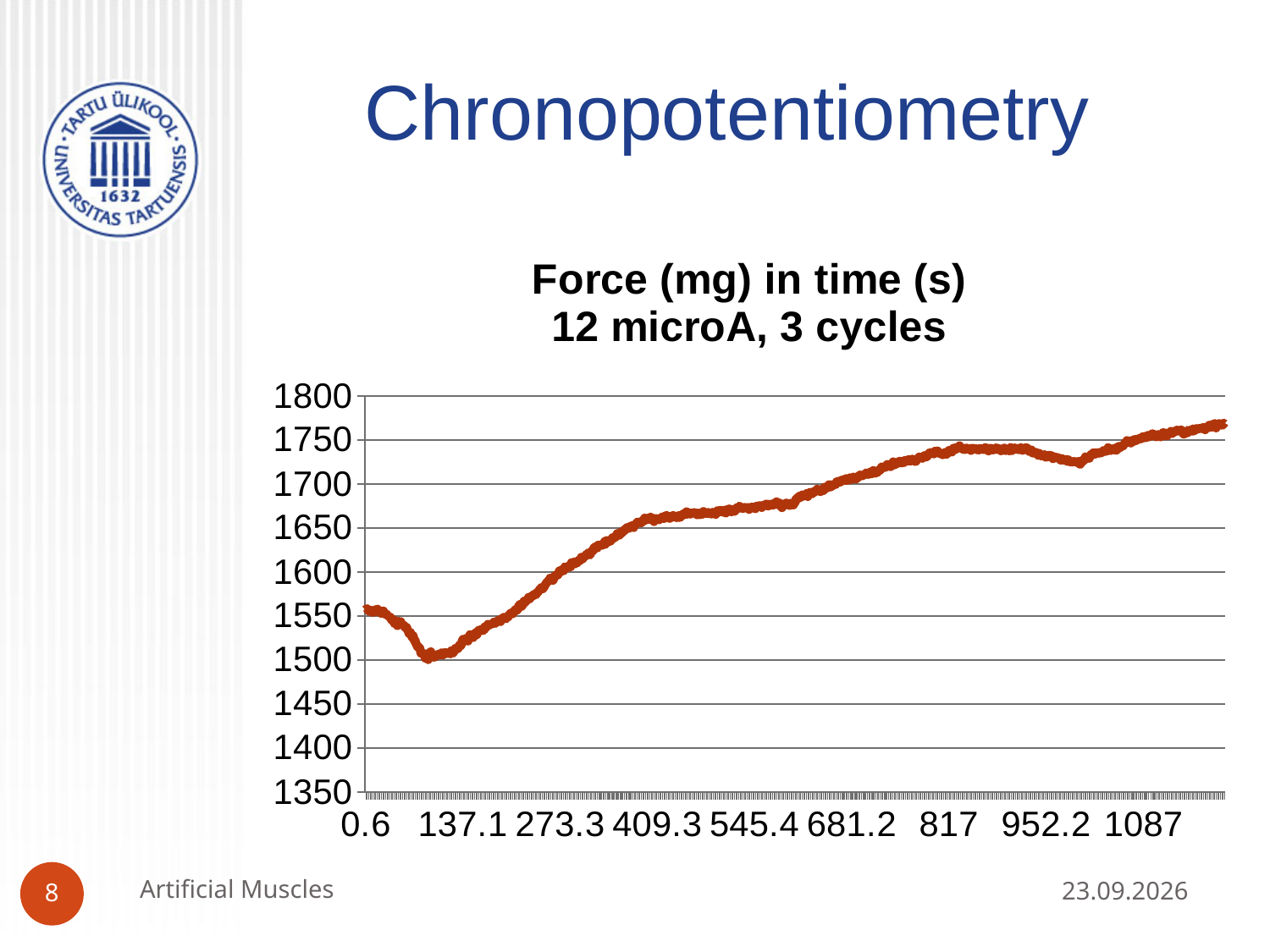
How many tick labels are shown on the x axis? 9 Is the value at x = 0.6 greater or less than 1600? less Overall, does the force rise or fall along the x axis from 0.6 to 1087? rise Is the value at x = 1087 greater or less than 1800? less What is the title of the chart? Force (mg) in time (s) 12 microA, 3 cycles Is the value at x = 409.3 greater or less than 1600? greater What kind of chart is shown on the slide? line chart Which is larger, the value at x = 0.6 or the value at x = 1087? 1087